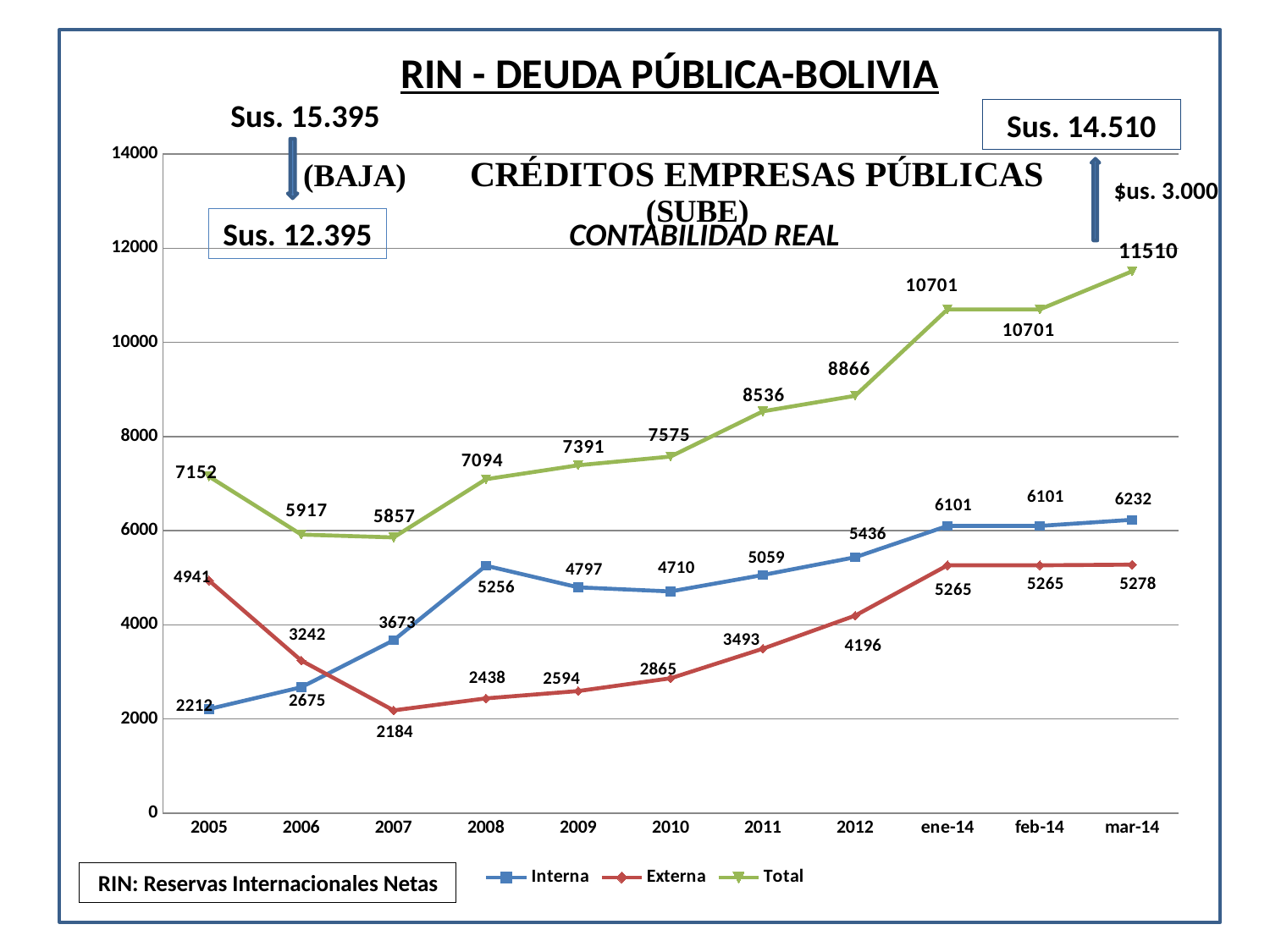
How many series does the legend list? 3 What is the value of the Interna series in 2008? 5256 How many points are plotted along the x axis for each series? 11 What is the difference between the Total value in mar-14 and the Total value in feb-14? 809 What is the value of the Total series in mar-14? 11510 In which year or month does the Externa series reach its lowest value? 2007 In which year or month does the Total series reach its highest value? mar-14 Which is larger in 2005, the Interna value or the Externa value? Externa What is the title of the chart? RIN - DEUDA PÚBLICA-BOLIVIA What is the value of the Externa series in 2007? 2184 What kind of chart is shown on the slide? Line chart Does the Total series rise or fall between 2008 and mar-14? Rise